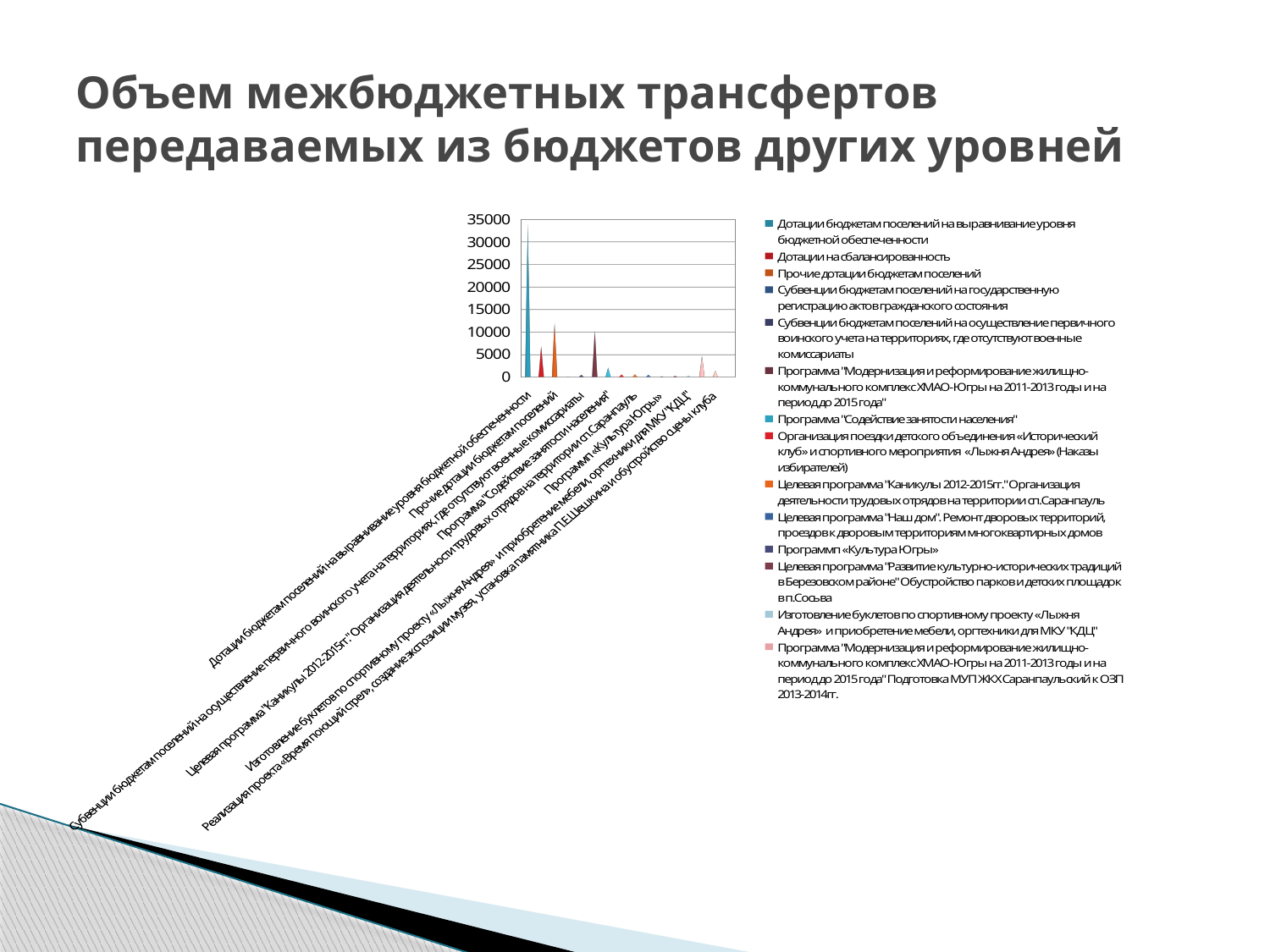
Is the peak value for "Дотации бюджетам поселений на выравнивание уровня бюджетной обеспеченности" greater or less than 30000? greater Which series has the highest peak on the chart? Дотации бюджетам поселений на выравнивание уровня бюджетной обеспеченности Is the peak value for "Прочие дотации бюджетам поселений" greater or less than 5000? greater How many series does the chart legend list? 14 Which is larger: the peak for "Дотации бюджетам поселений на выравнивание уровня бюджетной обеспеченности" or the peak for "Прочие дотации бюджетам поселений"? Дотации бюджетам поселений на выравнивание уровня бюджетной обеспеченности What kind of chart is shown on the slide? bar chart What is the highest value shown on the chart's vertical axis? 35000 What is the title of the slide containing the chart? Объем межбюджетных трансфертов передаваемых из бюджетов других уровней